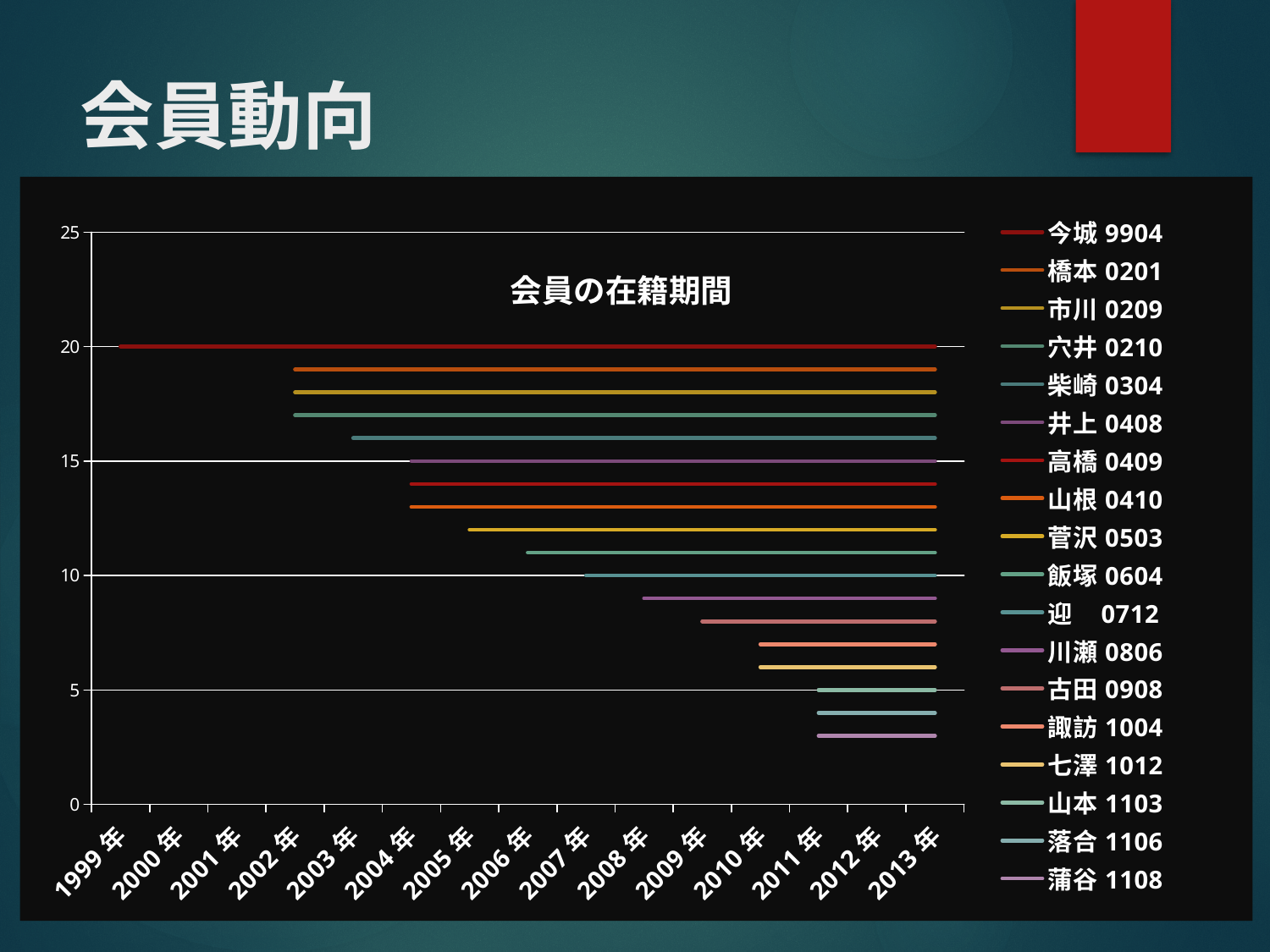
Which series has the lowest line on the chart? 蒲谷 1108 How many year labels are shown on the x axis? 15 At what y-axis value does the line for 井上 0408 lie? 15 Which series has the highest line on the chart? 今城 9904 At what y-axis value does the line for 山本 1103 lie? 5 What kind of chart is shown on the slide? line chart How many series does the legend list? 18 Which series starts earliest on the x axis? 今城 9904 What is the title of the chart? 会員の在籍期間 Is the line for 蒲谷 1108 greater or less than 5 on the y axis? less At what y-axis value does the line for 迎 0712 lie? 10 At what y-axis value does the line for 今城 9904 lie? 20